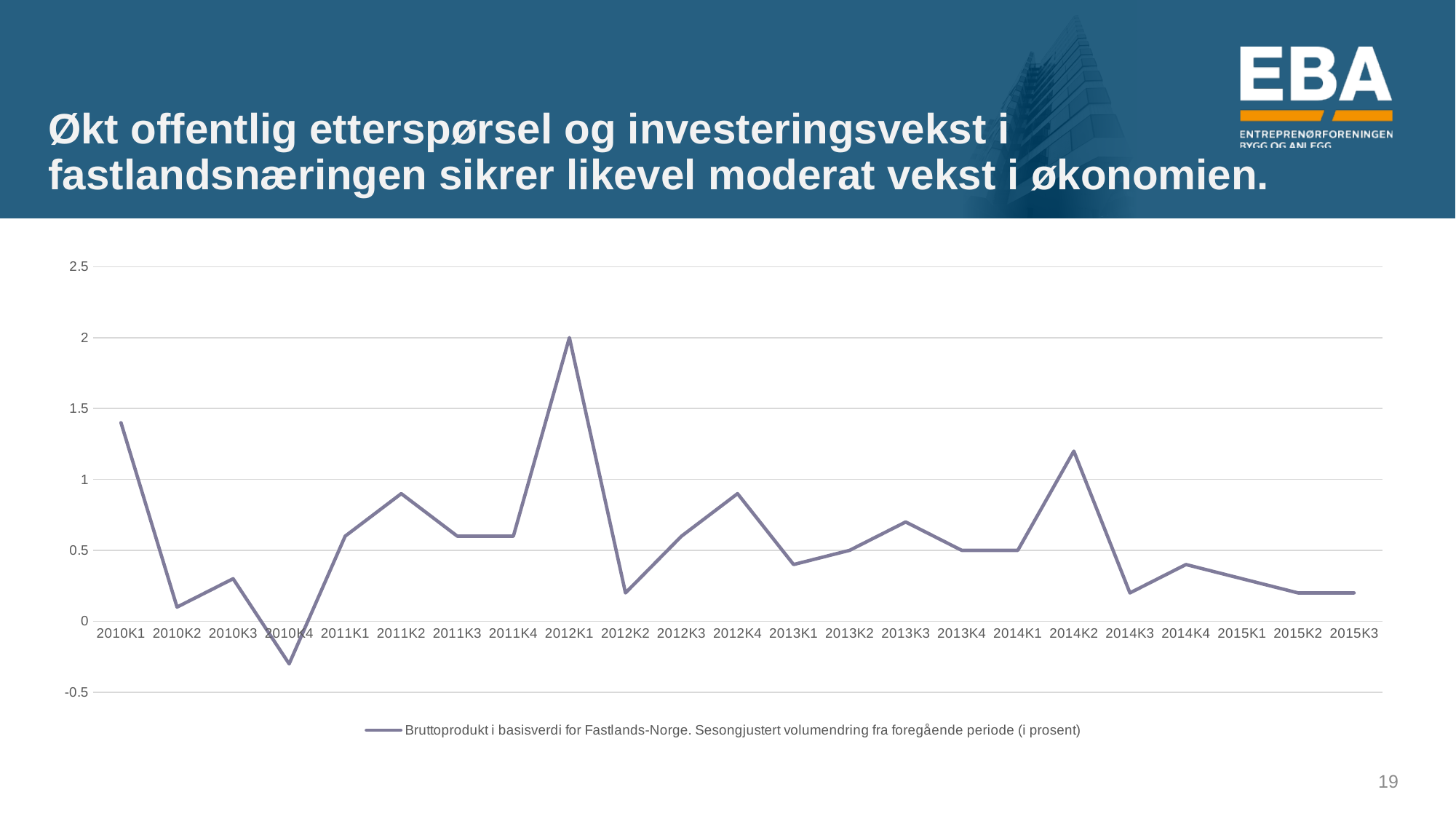
Do the values rise or fall from 2014K2 to 2015K3? fall Which quarter has the lowest value? 2010K4 How many quarters are plotted along the x axis? 23 What series name does the legend show? Bruttoprodukt i basisverdi for Fastlands-Norge. Sesongjustert volumendring fra foregående periode (i prosent) Which is larger, the value for 2010K1 or the value for 2014K2? 2010K1 Which quarter has the highest value? 2012K1 How many series does the legend list? 1 Is the value for 2010K4 greater or less than 0? less What kind of chart is shown on the slide? line chart Is the value for 2015K3 greater or less than 0.5? less What is the value for 2012K1? 2 Is the value for 2010K1 greater or less than 1? greater